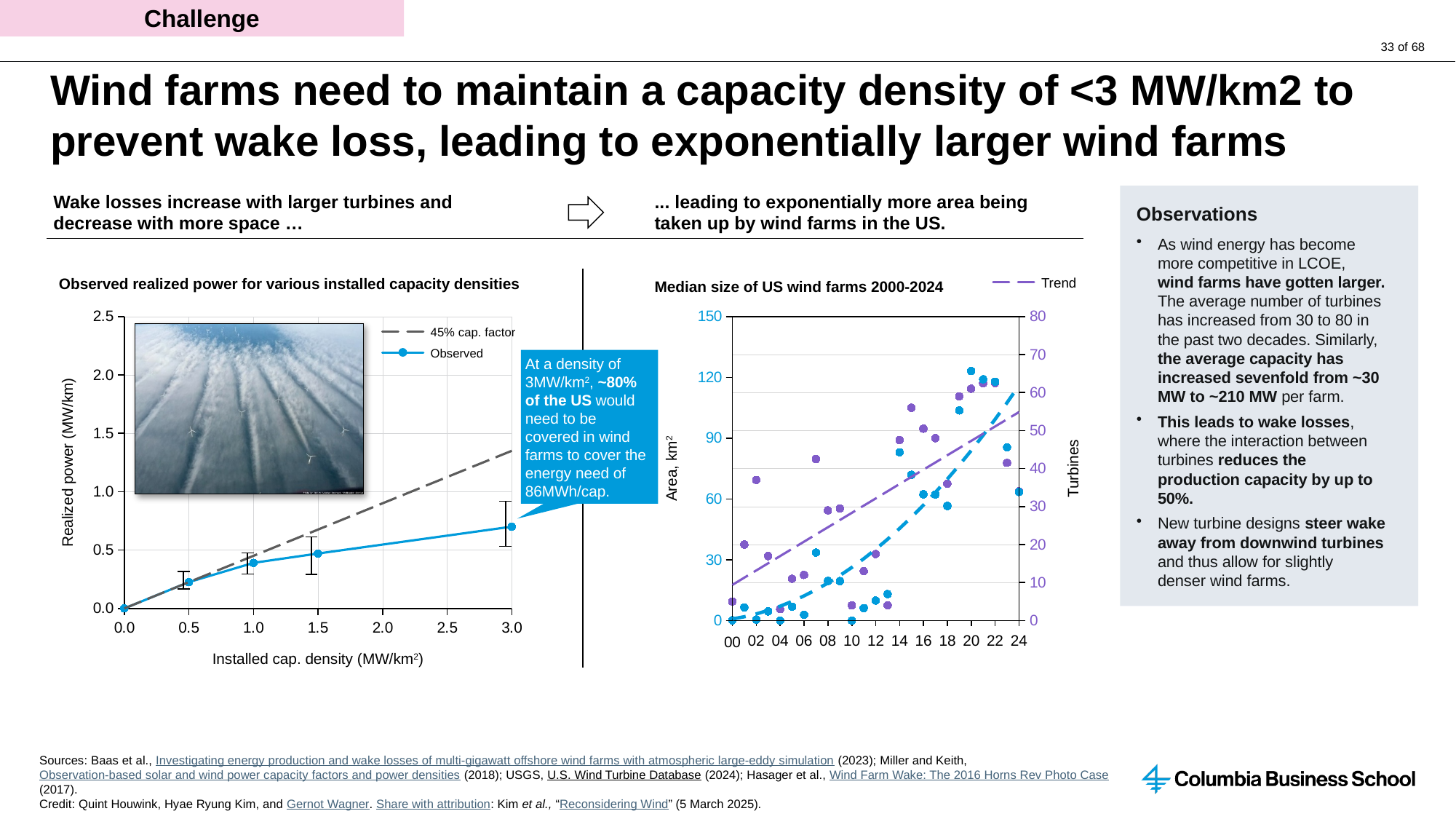
In the left chart 'Observed realized power for various installed capacity densities', what is the label of the x axis? Installed cap. density (MW/km²) In the right chart 'Median size of US wind farms 2000-2024', is the median area in 2019 greater or less than 90 km²? greater In the left chart 'Observed realized power for various installed capacity densities', how many series does the legend list? 2 What kind of chart is the left chart titled 'Observed realized power for various installed capacity densities'? line chart In the left chart 'Observed realized power for various installed capacity densities', what are the two legend entries? 45% cap. factor and Observed In the left chart 'Observed realized power for various installed capacity densities', how many Observed data points are plotted? 5 In the left chart 'Observed realized power for various installed capacity densities', is the Observed value at an installed capacity density of 1.5 MW/km² greater or less than 1.0? less In the right chart 'Median size of US wind farms 2000-2024', do the median area values generally rise or fall from 2000 to 2024? rise In the right chart 'Median size of US wind farms 2000-2024', is the median area in 2000 greater or less than 30 km²? less In the left chart 'Observed realized power for various installed capacity densities', does the Observed realized power rise or fall as installed capacity density increases? rise What kind of chart is the right chart titled 'Median size of US wind farms 2000-2024'? scatter chart